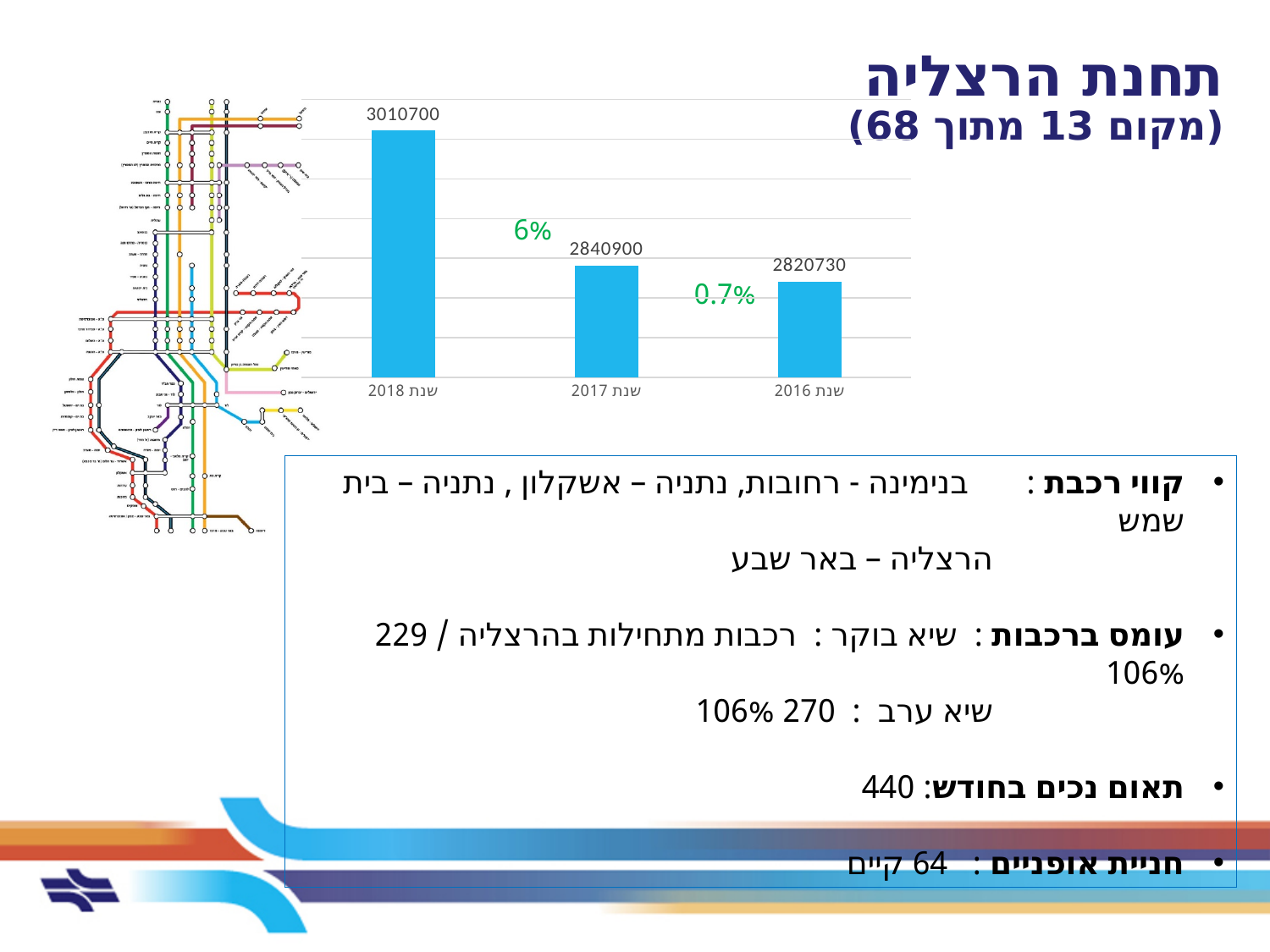
Do the values rise or fall from שנת 2016 to שנת 2018? rise What is the difference between the values for שנת 2018 and שנת 2017? 169800 What is the value for שנת 2018 in the bar chart? 3010700 Which year has the lowest value in the bar chart? שנת 2016 How many bars are shown in the chart? 3 What percentage label is shown between the שנת 2018 and שנת 2017 bars? 6% What is the difference between the values for שנת 2017 and שנת 2016? 20170 What kind of chart is shown on the slide? bar chart What is the value for שנת 2016 in the bar chart? 2820730 What is the value for שנת 2017 in the bar chart? 2840900 Which year has the highest value in the bar chart? שנת 2018 Which is larger, the value for שנת 2018 or the value for שנת 2016? שנת 2018